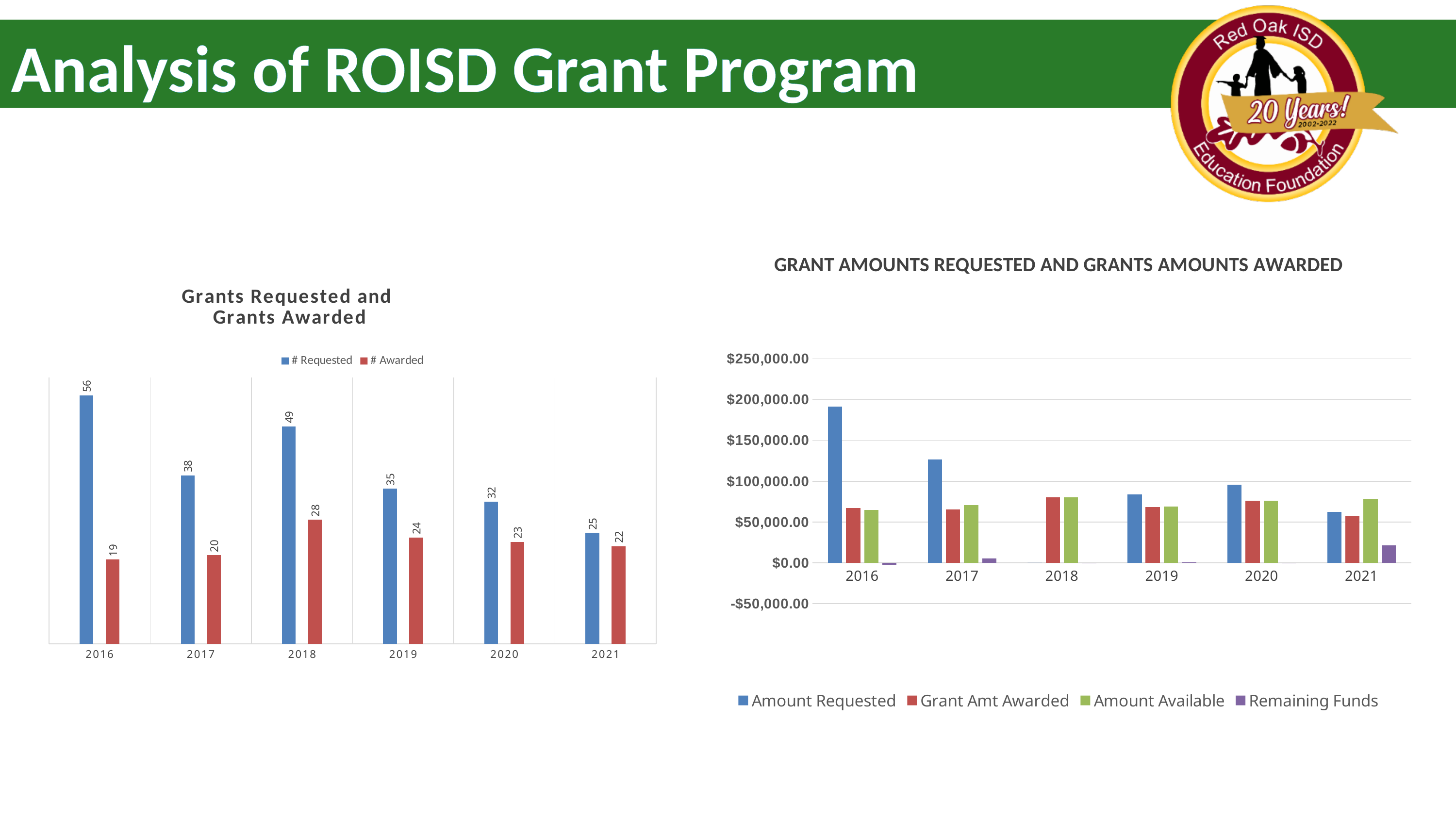
In the 'GRANT AMOUNTS REQUESTED AND GRANTS AMOUNTS AWARDED' chart, how many series does the legend list? 4 In the 'Grants Requested and Grants Awarded' chart, which year has the highest number of grants requested? 2016 In the 'GRANT AMOUNTS REQUESTED AND GRANTS AMOUNTS AWARDED' chart, is the Amount Requested for 2021 greater or less than $100,000.00? less In the 'Grants Requested and Grants Awarded' chart, how many grants were requested in 2016? 56 In the 'Grants Requested and Grants Awarded' chart, what is the difference between the number requested and the number awarded in 2016? 37 In the 'Grants Requested and Grants Awarded' chart, which year has the lowest number of grants awarded? 2016 In the 'Grants Requested and Grants Awarded' chart, does the number of grants requested rise or fall from 2019 to 2021? fall In the 'GRANT AMOUNTS REQUESTED AND GRANTS AMOUNTS AWARDED' chart, is the Amount Requested for 2016 greater or less than $150,000.00? greater In the 'Grants Requested and Grants Awarded' chart, what is the difference between the number requested in 2018 and the number requested in 2019? 14 In the 'Grants Requested and Grants Awarded' chart, how many years are shown on the x axis? 6 In the 'Grants Requested and Grants Awarded' chart, how many grants were awarded in 2018? 28 What kind of chart is the 'GRANT AMOUNTS REQUESTED AND GRANTS AMOUNTS AWARDED' chart? bar chart